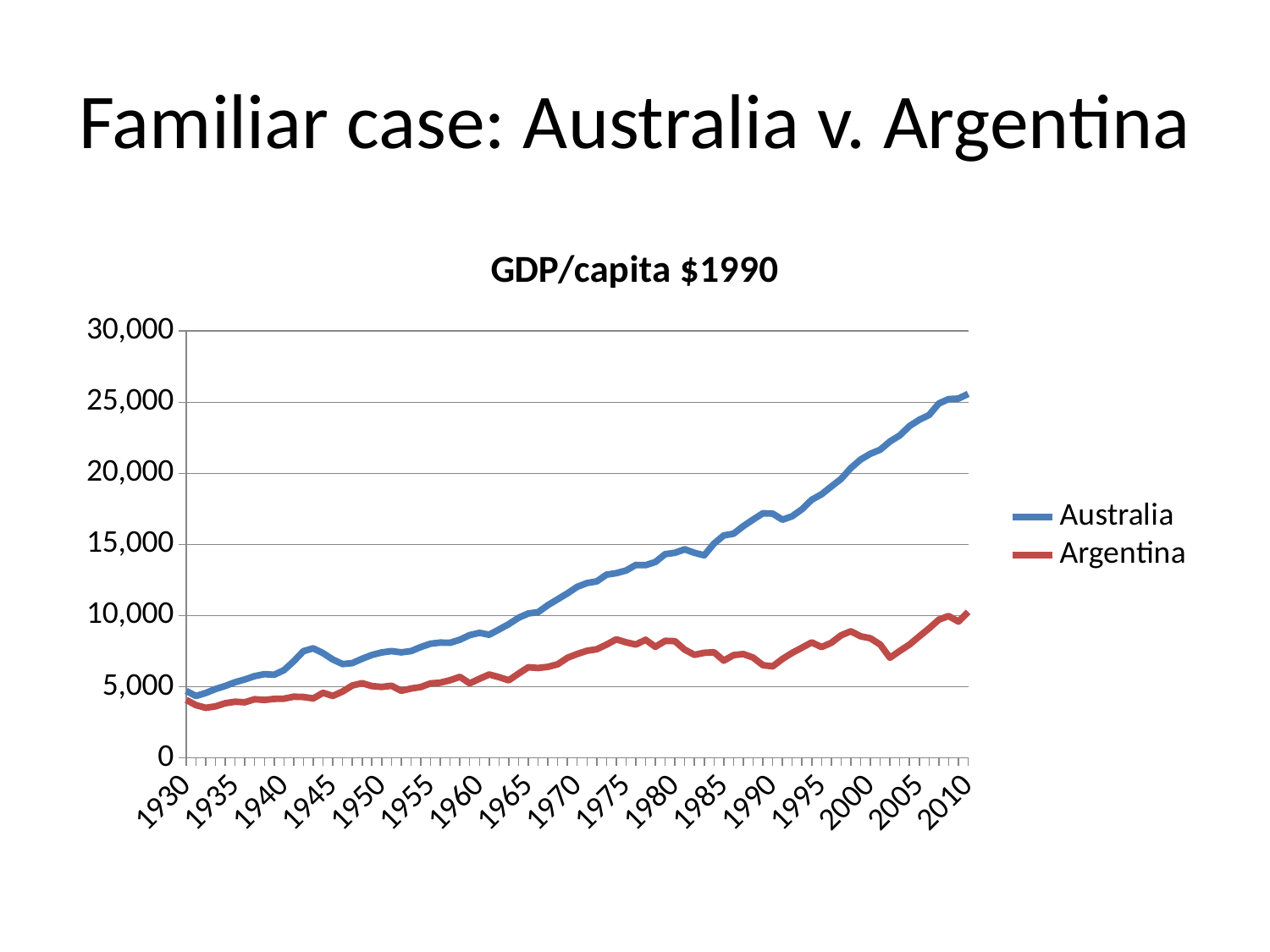
Which series has the higher value in 1990, Australia or Argentina? Australia Is the value for Australia in 1970 greater or less than 10,000? greater Which colour is used for the Argentina line? Red How many series does the legend list? 2 What kind of chart is shown on the slide? Line chart Is the value for Argentina in 1990 greater or less than 10,000? less Does the Australia line generally rise or fall from 1930 to 2010? Rise Is the value for Australia in 2010 greater or less than 20,000? greater What is the title of the chart? GDP/capita $1990 Which series has the higher value in 2010, Australia or Argentina? Australia